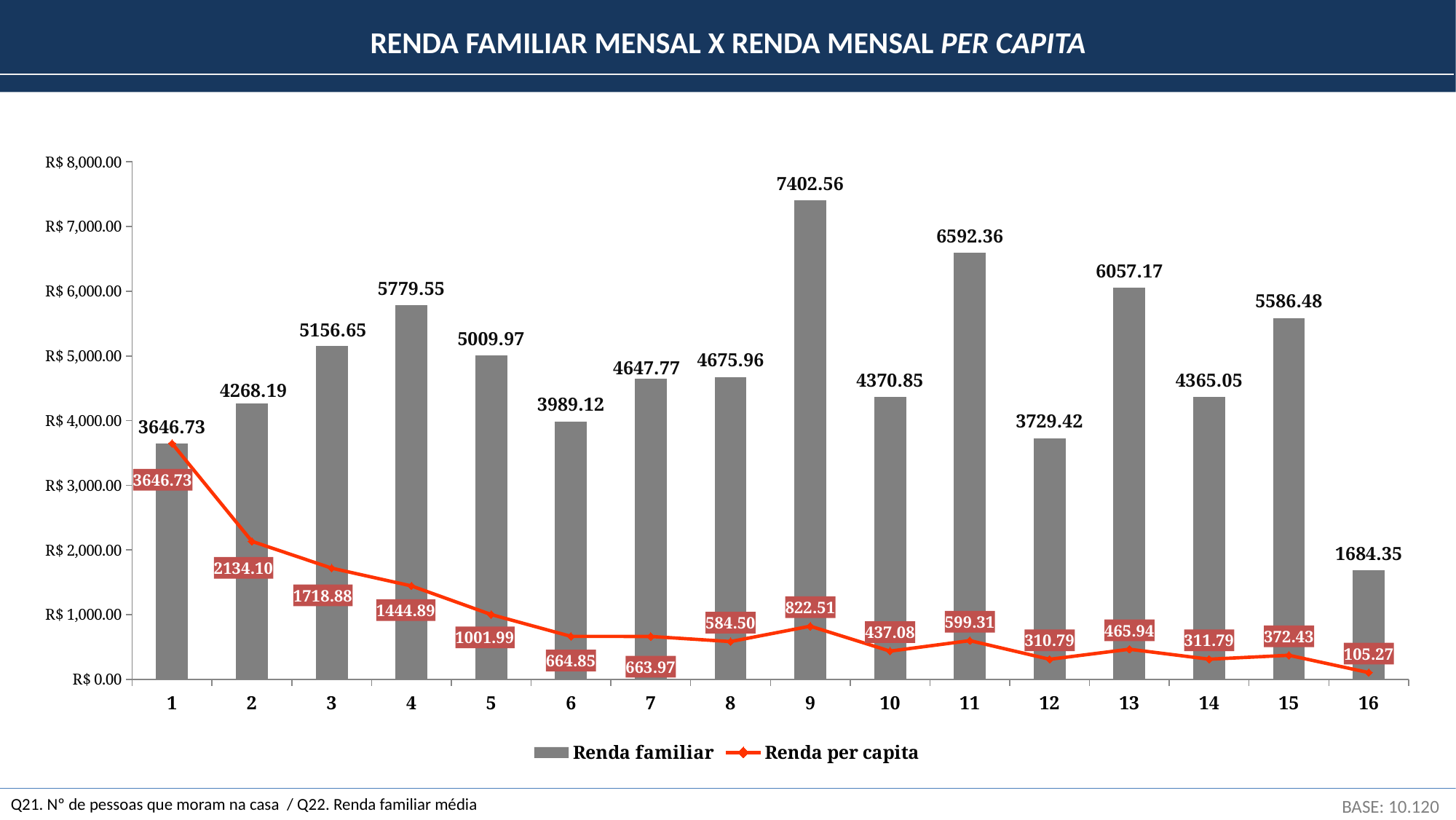
Which category has the lowest Renda per capita value? 16 What is the Renda familiar value for category 9? 7402.56 What is the Renda per capita value for category 4? 1444.89 Does the Renda per capita line generally rise or fall from category 1 to category 16? fall Which is larger, the Renda familiar value for category 11 or for category 13? 11 How many series does the legend list? 2 What is the difference between the Renda familiar values for categories 9 and 16? 5718.21 Which category has the highest Renda familiar value? 9 What is the difference between the Renda per capita values for categories 1 and 2? 1512.63 How many categories are shown on the x axis? 16 What kind of chart is shown on the slide? Combined bar and line chart Is the Renda familiar value for category 15 greater or less than R$ 5,000.00? greater